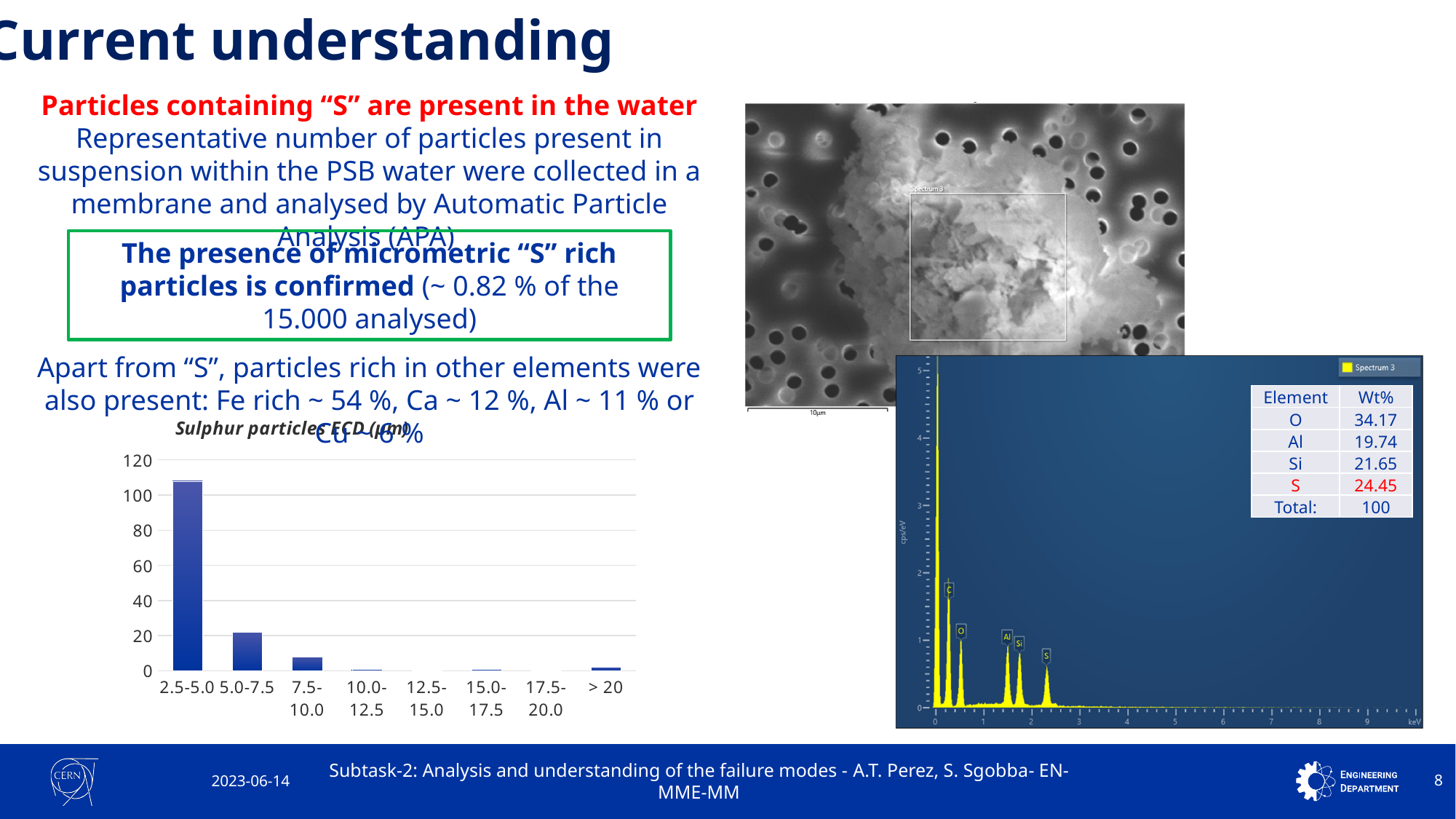
On the bar chart titled 'Sulphur particles ECD (µm)', how many size categories are shown on the x axis? 8 On the bar chart titled 'Sulphur particles ECD (µm)', is the value for 2.5-5.0 greater or less than 100? greater On the bar chart titled 'Sulphur particles ECD (µm)', which size category has the highest bar? 2.5-5.0 On the bar chart titled 'Sulphur particles ECD (µm)', do the values generally rise or fall as the size category increases along the x axis? fall On the spectrum chart at the bottom right, what is the difference in Wt% between O and S in the element table? 9.72 On the bar chart titled 'Sulphur particles ECD (µm)', is the value for 7.5-10.0 greater or less than 20? less On the bar chart titled 'Sulphur particles ECD (µm)', is the value for 5.0-7.5 greater or less than 40? less On the spectrum chart at the bottom right, what is the Wt% of S in the element table? 24.45 On the bar chart titled 'Sulphur particles ECD (µm)', which is larger, the value for 5.0-7.5 or the value for 7.5-10.0? 5.0-7.5 On the spectrum chart at the bottom right, what name does the legend give the spectrum? Spectrum 3 On the bar chart titled 'Sulphur particles ECD (µm)', what kind of chart is shown? bar chart On the spectrum chart at the bottom right, which element has the highest Wt% in the element table? O